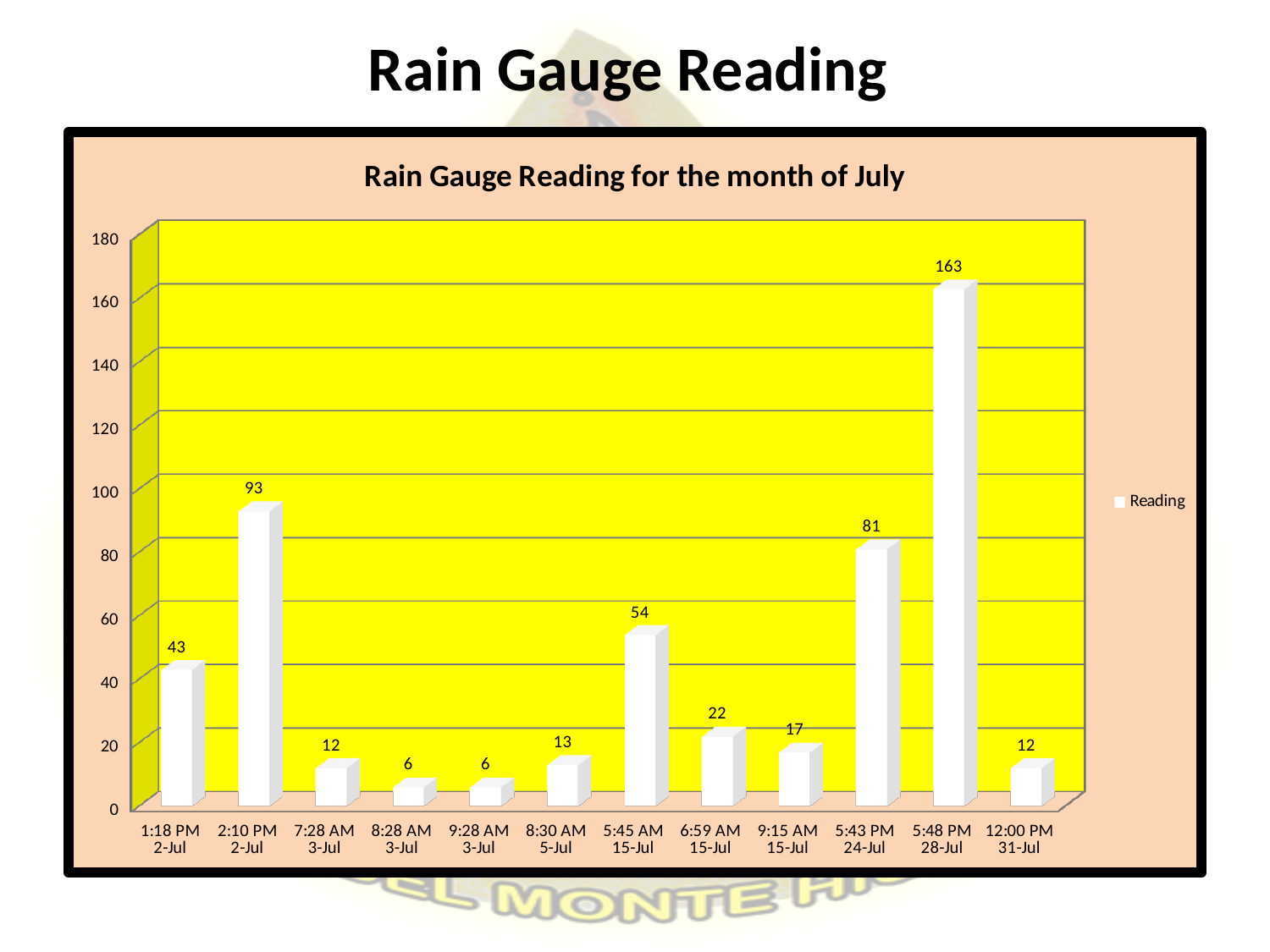
What is the difference between the readings at 5:48 PM on 28-Jul and 2:10 PM on 2-Jul? 70 Which is larger, the reading at 1:18 PM on 2-Jul or the reading at 6:59 AM on 15-Jul? 1:18 PM 2-Jul Which reading time has the highest rain gauge reading? 5:48 PM 28-Jul What is the highest rain gauge reading shown on the chart? 163 What is the title of the chart? Rain Gauge Reading for the month of July What kind of chart is shown on the slide? Bar chart What is the rain gauge reading at 5:43 PM on 24-Jul? 81 What is the rain gauge reading at 5:45 AM on 15-Jul? 54 What is the rain gauge reading at 2:10 PM on 2-Jul? 93 How many series does the legend list? 1 What is the lowest rain gauge reading shown on the chart? 6 How many readings are plotted on the chart? 12